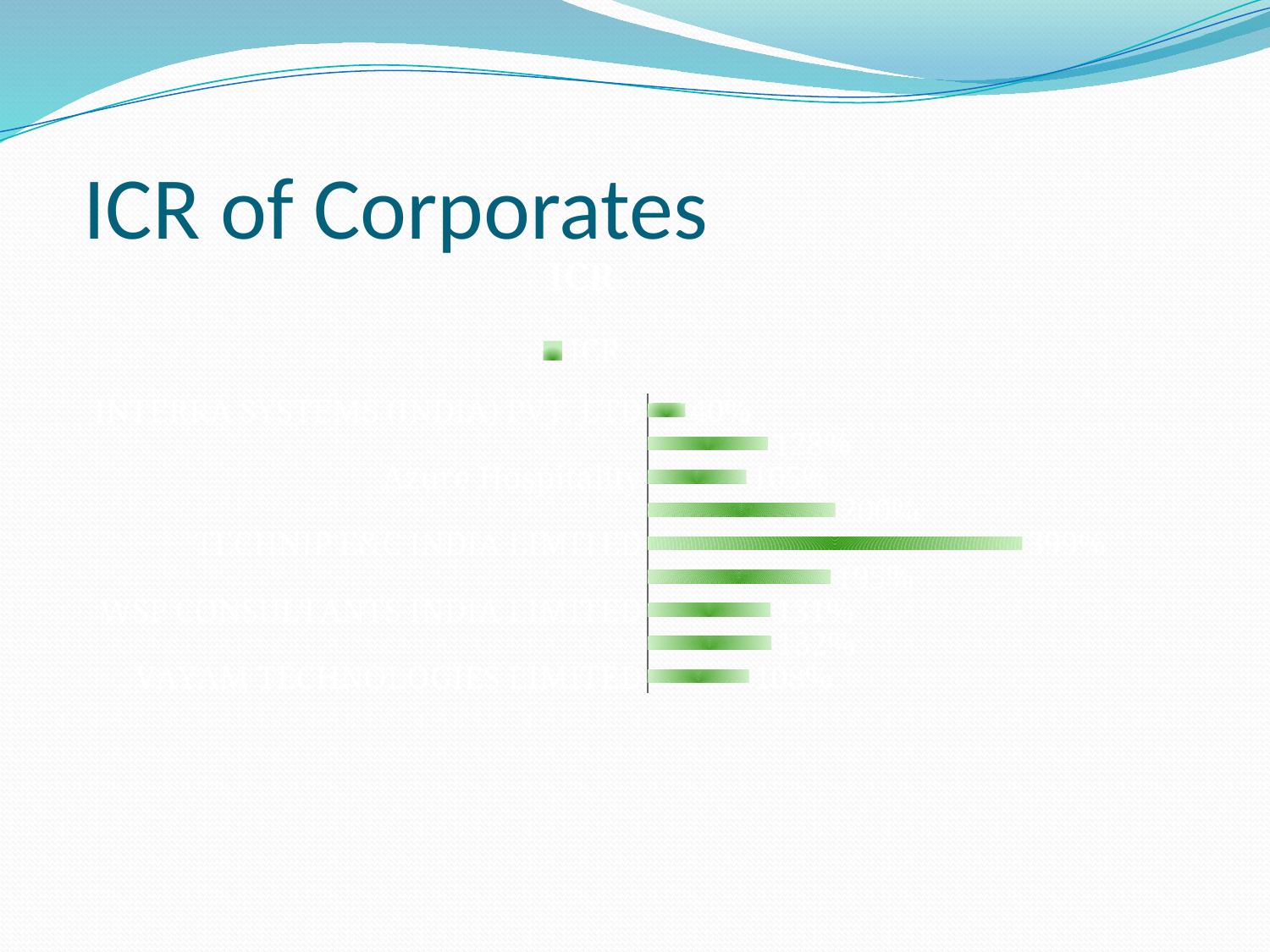
What is the ICR value for Azure Hospitality? 105% What is the difference between the ICR of TECHNIP E&C INDIA LIMITED and INTERRA SYSTEMS (INDIA) PVT. LTD? 359% How many series does the legend list? 1 What is the ICR value for WSP CONSULTANTS INDIA LIMITED? 131% Which company has the lowest ICR? INTERRA SYSTEMS (INDIA) PVT. LTD What is the title of the chart? ICR How many bars are plotted in the chart? 9 Which company has the highest ICR? TECHNIP E&C INDIA LIMITED What is the ICR value for VAYAM TECHNOLOGIES LIMITED? 108% What is the ICR value for INTERRA SYSTEMS (INDIA) PVT. LTD? 40% What is the ICR value for TECHNIP E&C INDIA LIMITED? 399% What type of chart is shown on the slide? bar chart